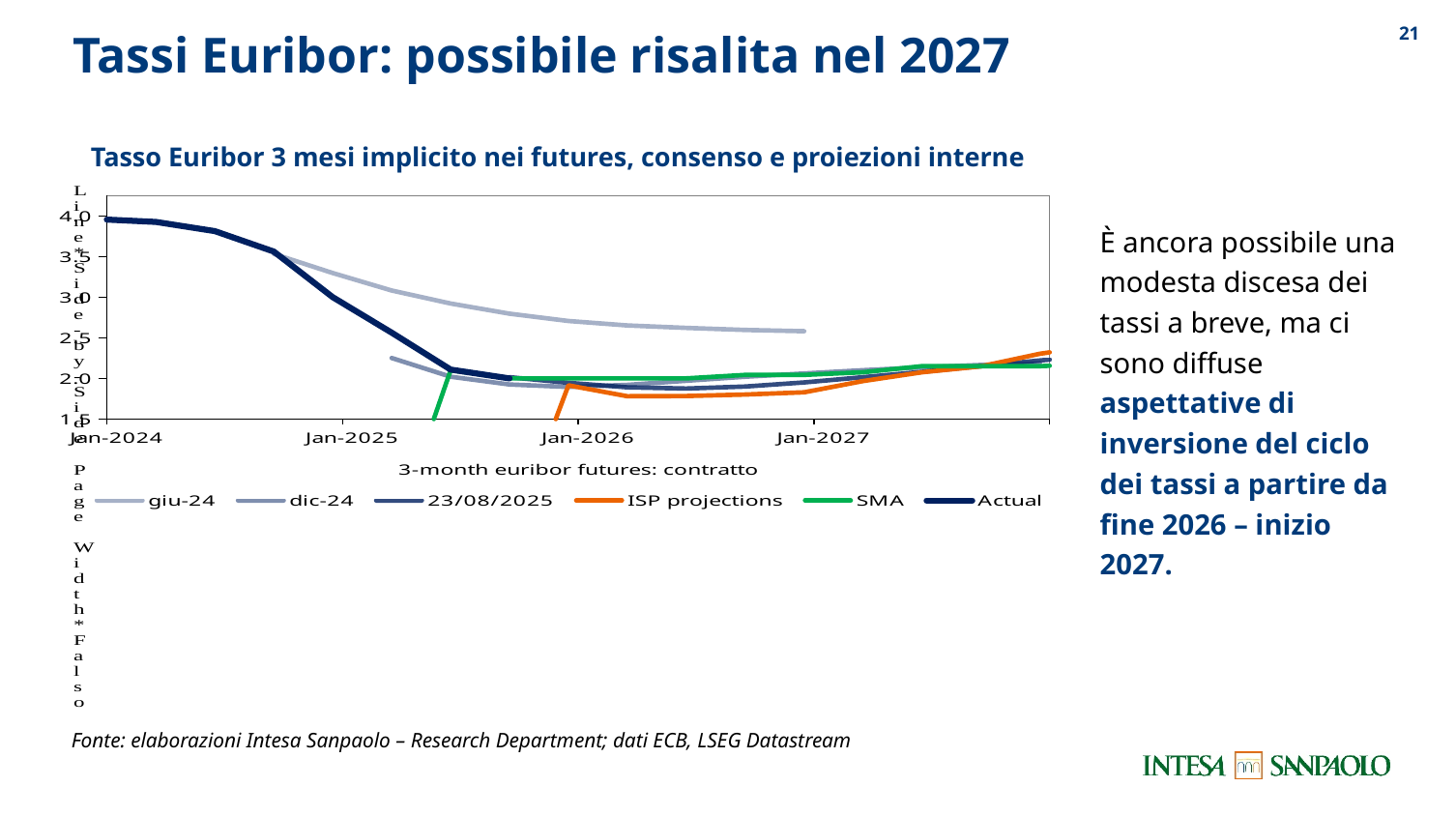
How many year labels are shown on the x axis of the chart? 4 Is the value of the Actual series at Jan-2024 greater or less than 3.5? greater Does the ISP projections series rise or fall from Jan-2027 to its end? Rise How many series does the legend of the chart list? 6 Which series in the legend is drawn in orange? ISP projections Does the Actual series rise or fall from Jan-2024 to Jan-2025? Fall Does the giu-24 series rise or fall along the x axis? Fall Is the value of the giu-24 series at Jan-2027 greater or less than 2.0? greater What kind of chart is shown on the slide? Line chart At Jan-2026, which series is higher: giu-24 or dic-24? giu-24 Is the value of the ISP projections series at Jan-2026 greater or less than 2.5? less What is the title of the chart? Tasso Euribor 3 mesi implicito nei futures, consenso e proiezioni interne